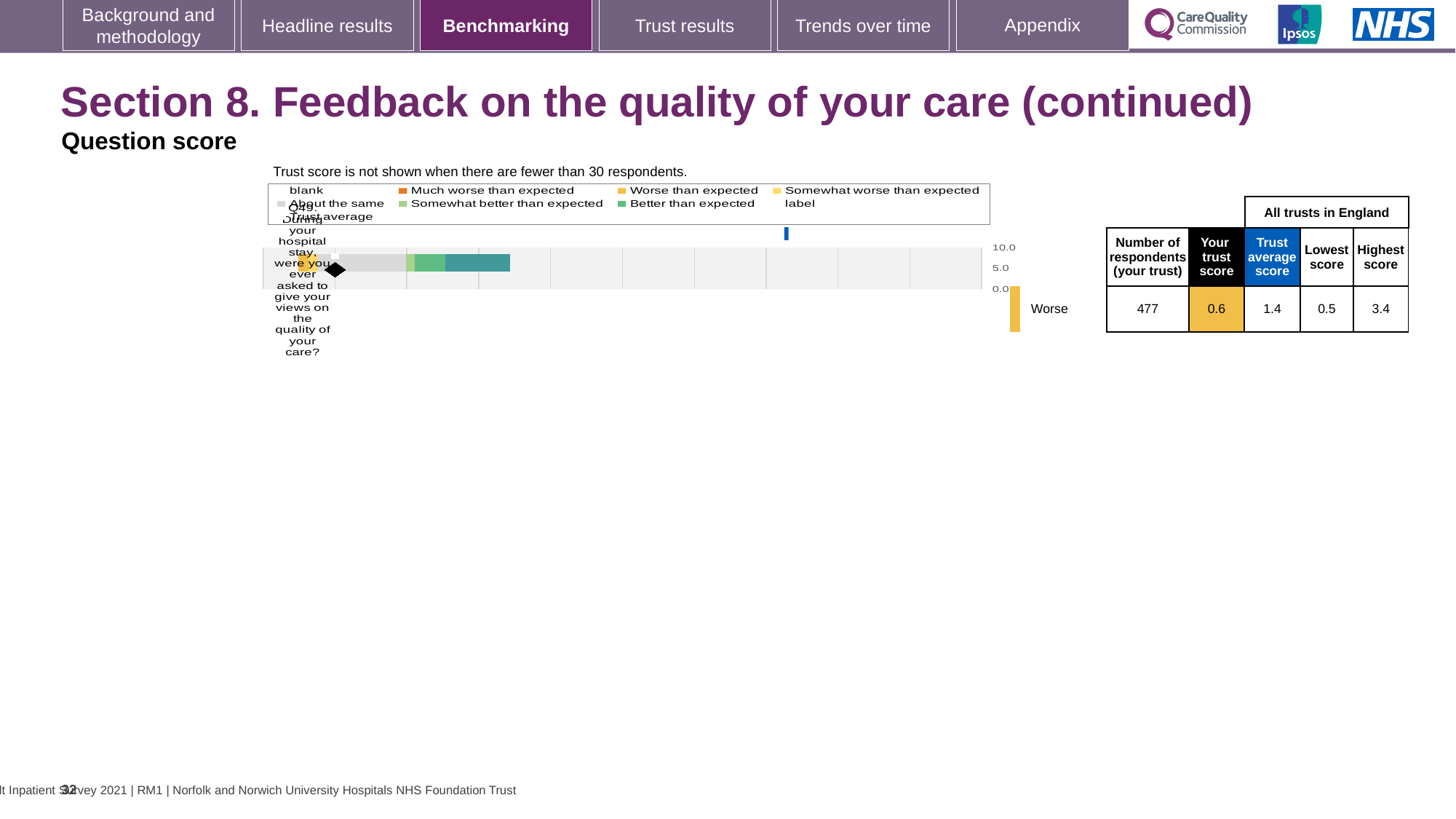
What is the lowest score among all trusts in England for Q49? 0.5 What is the trust average score for Q49? 1.4 What is the highest score among all trusts in England for Q49? 3.4 How many respondents from your trust answered Q49? 477 Is your trust score for Q49 greater or less than 5.0? less What is the difference between the trust average score and your trust score for Q49? 0.8 Which benchmark category is your trust score for Q49 labelled as? Worse What kind of chart is shown on the slide? bar chart Which is larger for Q49: your trust score or the trust average score? Trust average score How many questions are plotted on the chart? 1 What is the difference between the highest and lowest scores among all trusts in England for Q49? 2.9 What is the trust score for Q49 (During your hospital stay, were you ever asked to give your views on the quality of your care?)? 0.6